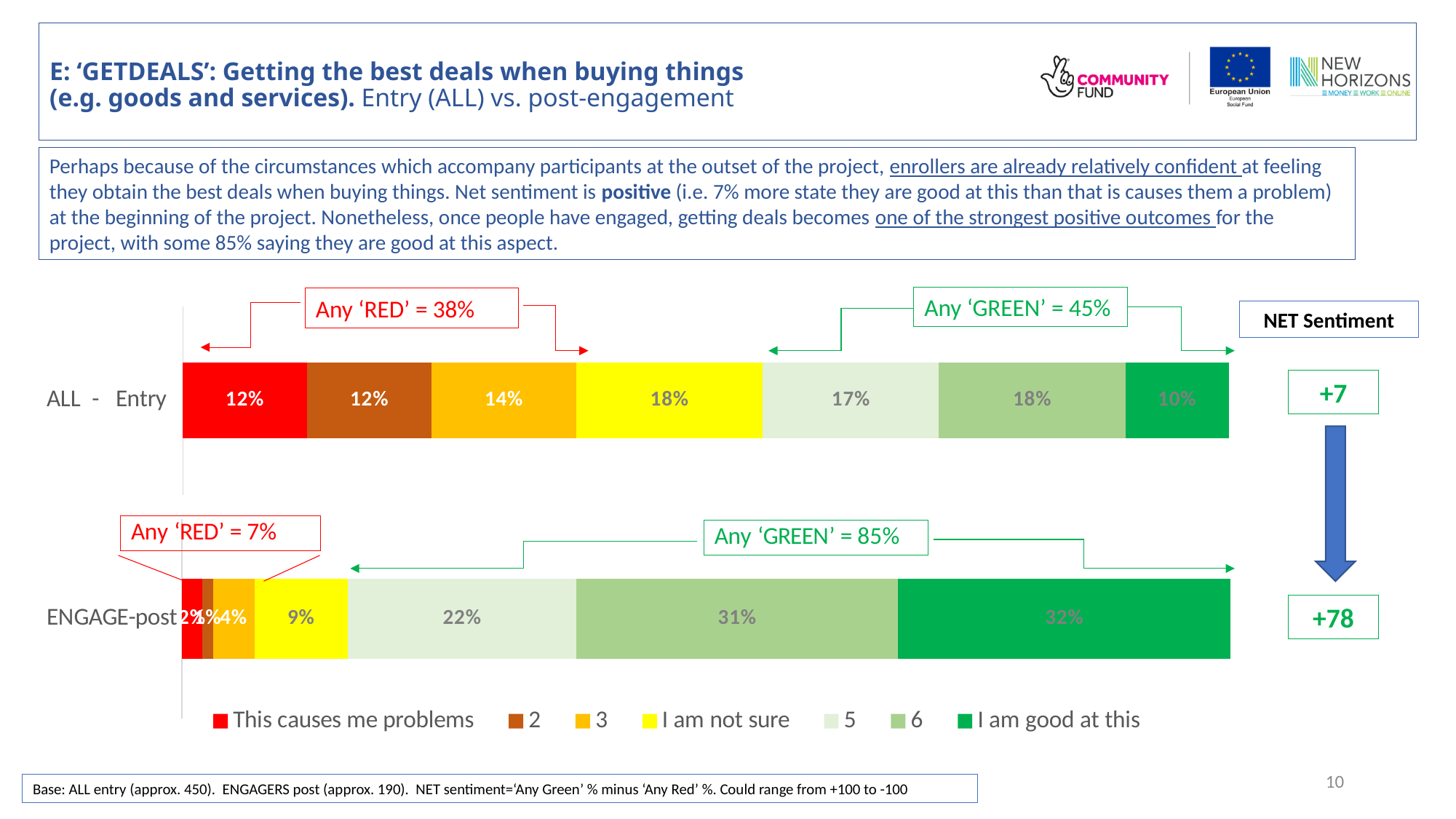
How many bars (categories) are plotted in the chart? 2 Which segment is the smallest in the ENGAGE-post bar? 2 What is the value of 'I am good at this' for the ALL - Entry bar? 10% What is the value of 'I am good at this' for the ENGAGE-post bar? 32% Which bar has the larger value for series 6, ALL - Entry or ENGAGE-post? ENGAGE-post How many series does the chart legend list? 7 What is the value of 'I am not sure' for the ALL - Entry bar? 18% What type of chart is shown on the slide? stacked bar chart What NET Sentiment value is shown for the ENGAGE-post bar? +78 What is the value of 'This causes me problems' for the ENGAGE-post bar? 2% Which segment is the largest in the ENGAGE-post bar? I am good at this What is the difference between the 'I am good at this' values for ENGAGE-post and ALL - Entry? 22%